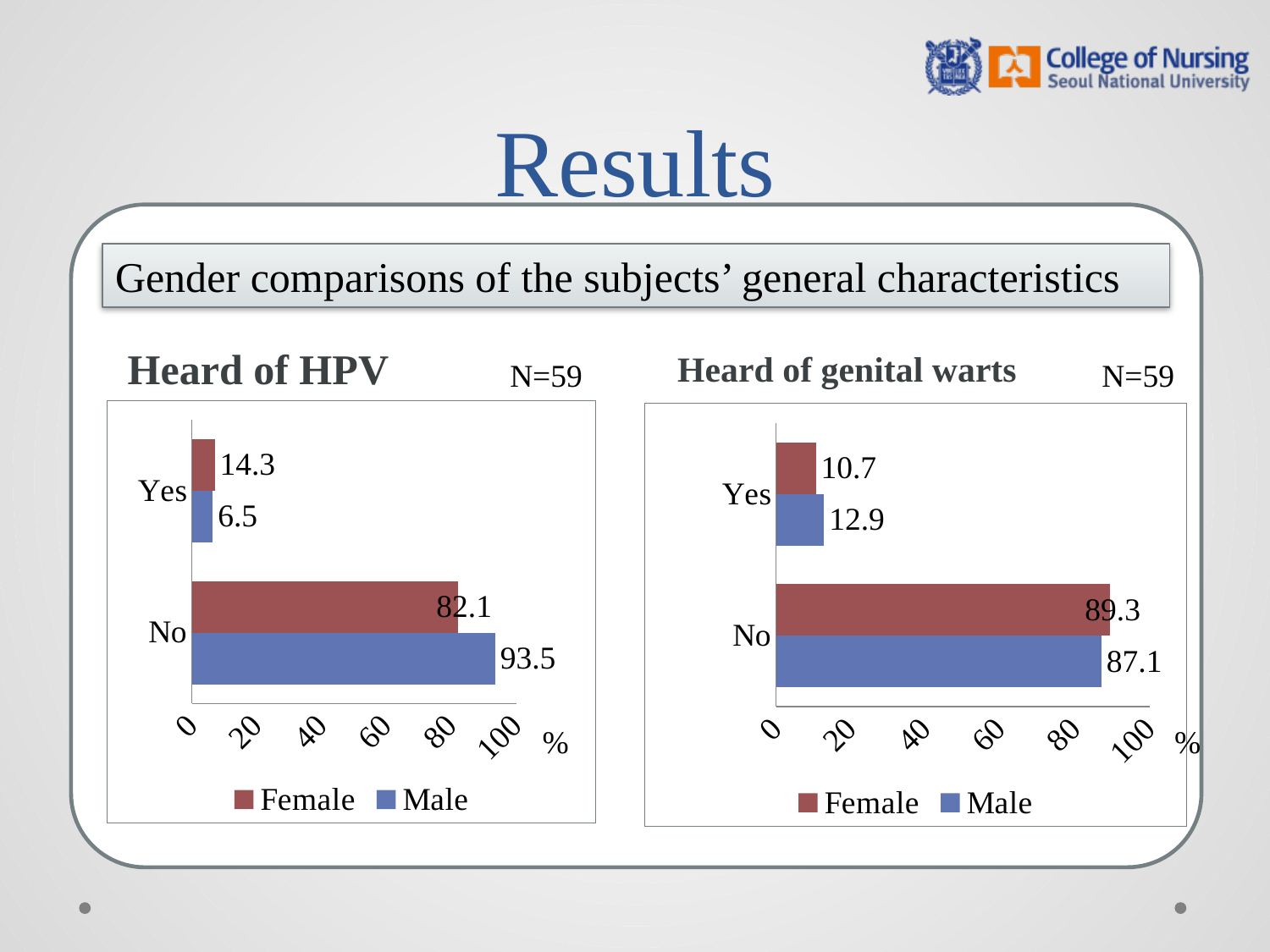
What kind of chart is the 'Heard of HPV' chart? Bar chart In the 'Heard of HPV' chart, what is the value for Male in the No category? 93.5 How many series does the legend of the 'Heard of genital warts' chart list? 2 In the 'Heard of HPV' chart, which is larger in the Yes category, Female or Male? Female In the 'Heard of genital warts' chart, which is larger in the No category, Female or Male? Female In the 'Heard of genital warts' chart, what is the value for Female in the No category? 89.3 In the 'Heard of genital warts' chart, what is the value for Male in the Yes category? 12.9 In the 'Heard of HPV' chart, which colour represents Male? Blue In the 'Heard of HPV' chart, what is the difference between the Male and Female values in the No category? 11.4 In the 'Heard of HPV' chart, what is the value for Female in the Yes category? 14.3 In the 'Heard of genital warts' chart, what is the difference between the Male and Female values in the Yes category? 2.2 In the 'Heard of HPV' chart, is the Male value for No greater or less than 80? greater